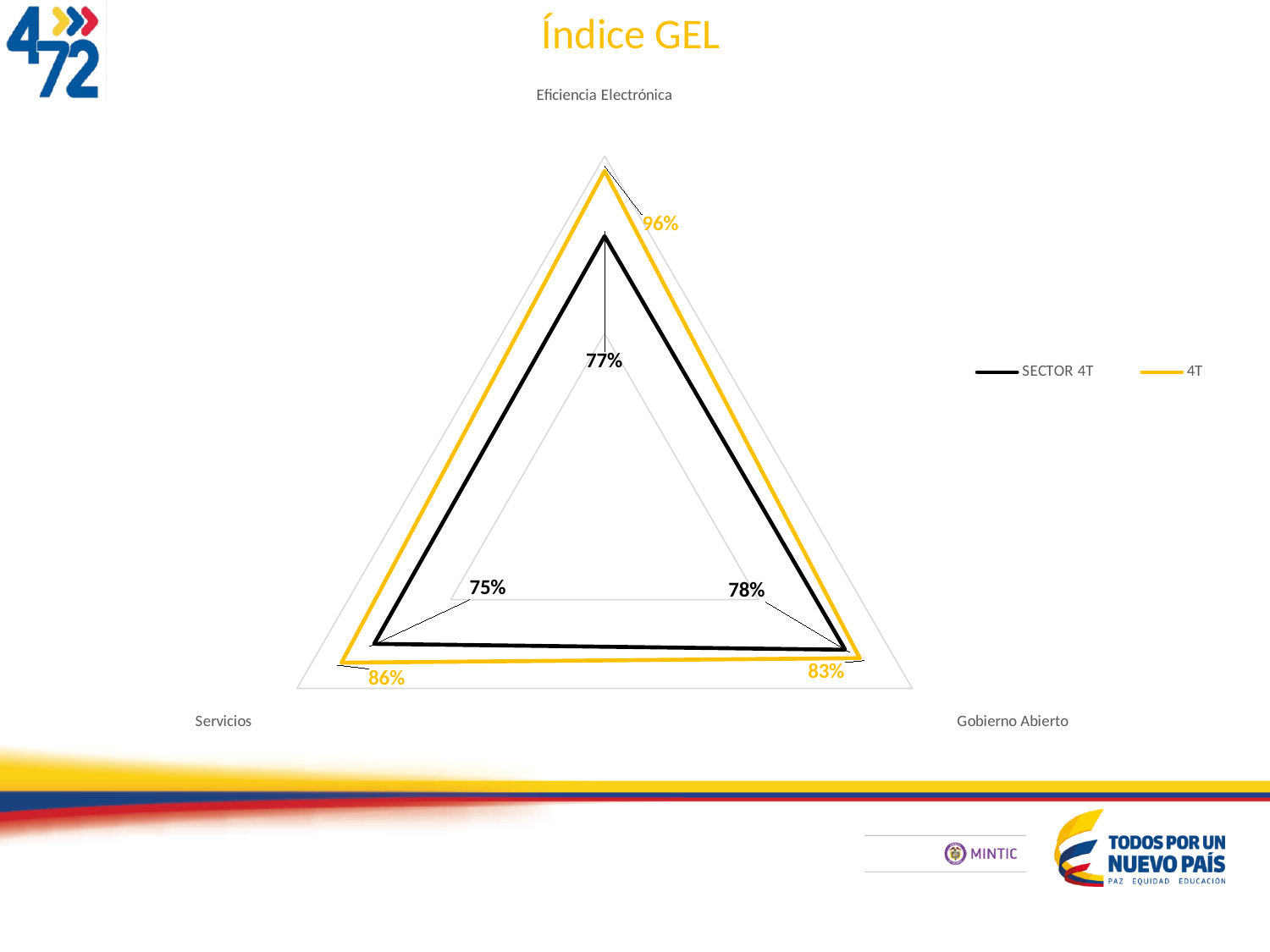
How many series does the legend list? 2 What is the value of the SECTOR 4T series for Gobierno Abierto? 78% What is the value of the 4T series for Eficiencia Electrónica? 96% Which series has the larger value for Gobierno Abierto, 4T or SECTOR 4T? 4T What is the value of the 4T series for Servicios? 86% Which category has the highest value for the 4T series? Eficiencia Electrónica How many categories are plotted on the chart? 3 What is the value of the 4T series for Gobierno Abierto? 83% What is the difference between the 4T and SECTOR 4T values for Servicios? 11% Which category has the lowest value for the SECTOR 4T series? Servicios What is the difference between the 4T and SECTOR 4T values for Eficiencia Electrónica? 19% What is the value of the SECTOR 4T series for Eficiencia Electrónica? 77%